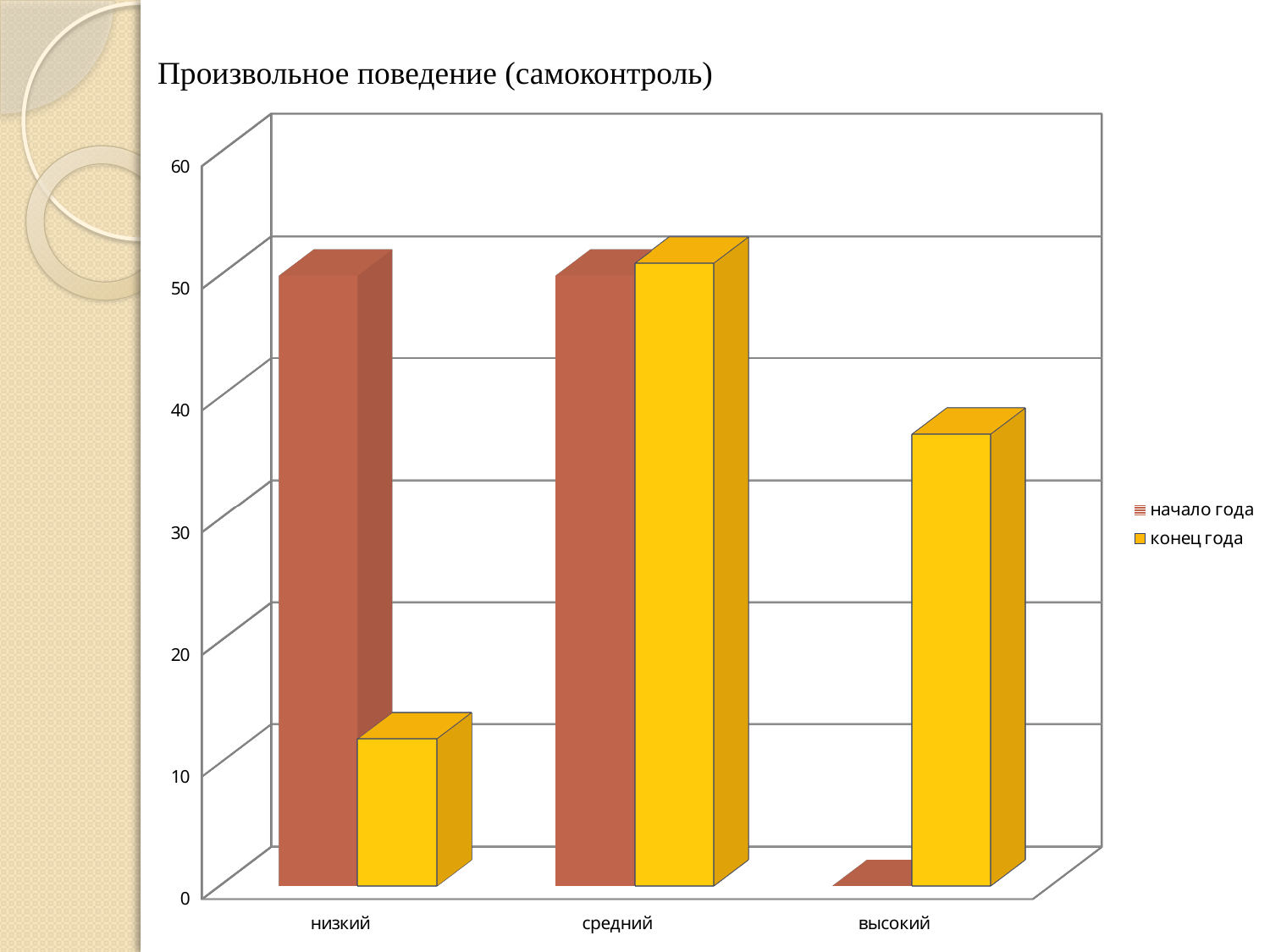
Is the value for конец года in the низкий category greater or less than 20? less In the низкий category, which series has the larger value, начало года or конец года? начало года For the начало года series, which category has the lowest value? высокий Is the value for конец года in the высокий category greater or less than 30? greater What kind of chart is shown on the slide? bar chart What is the title of the slide? Произвольное поведение (самоконтроль) Is the value for начало года in the низкий category greater or less than 40? greater In the высокий category, which series has the larger value, начало года or конец года? конец года For the конец года series, which category has the lowest value? низкий How many categories are shown on the x axis? 3 How many series does the legend list? 2 What colour are the bars for the конец года series? yellow